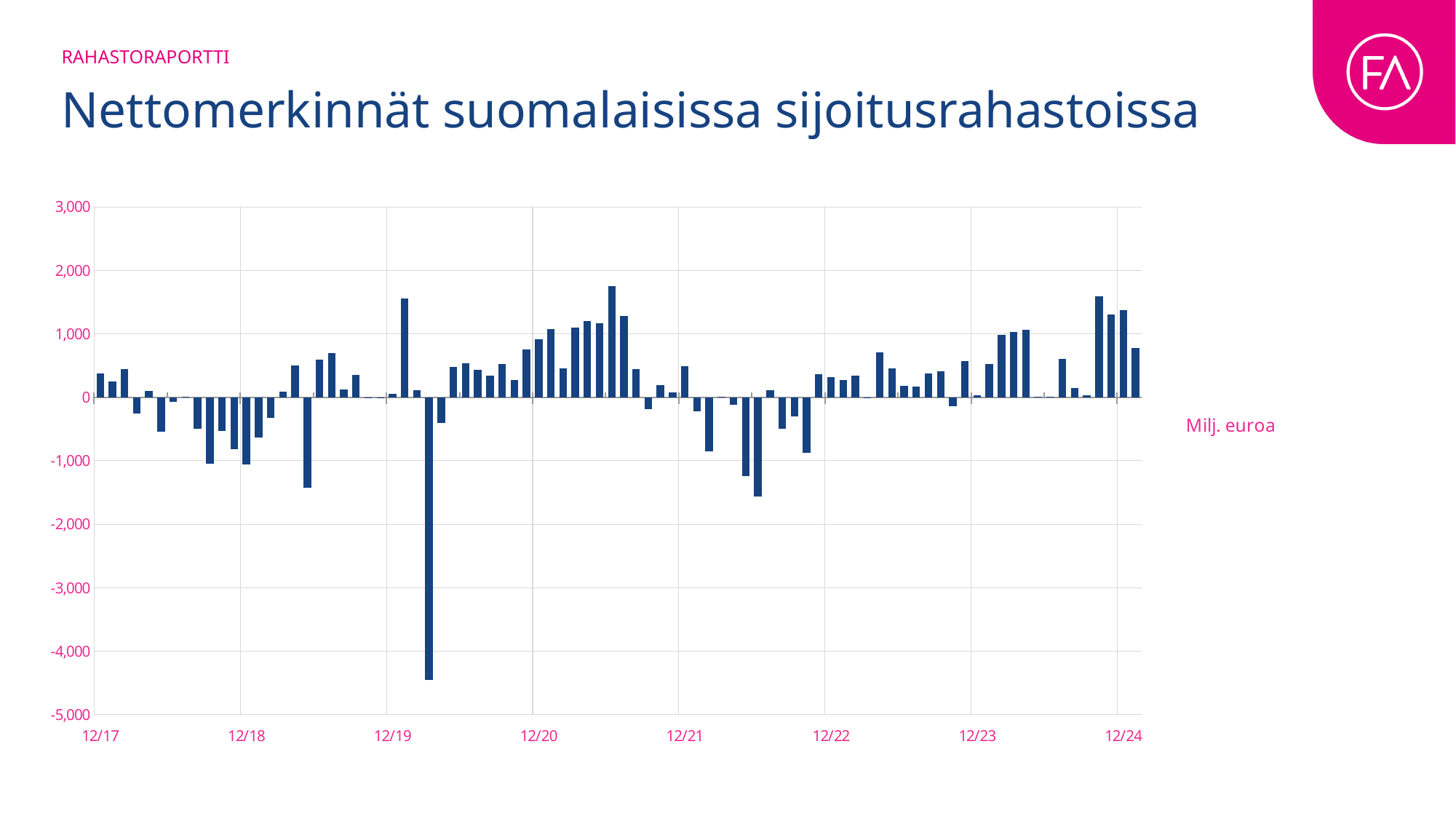
How many labels are shown on the x axis? 8 What is the first label on the x axis? 12/17 What is the last label on the x axis? 12/24 Is the lowest value on the chart greater or less than -4,000? less Is the value for 12/24 greater or less than 0? greater Is the value for 12/21 greater or less than 1,000? less What is the title of the chart on the slide? Nettomerkinnät suomalaisissa sijoitusrahastoissa What kind of chart is shown on the slide? Bar chart What unit is indicated next to the chart? Milj. euroa